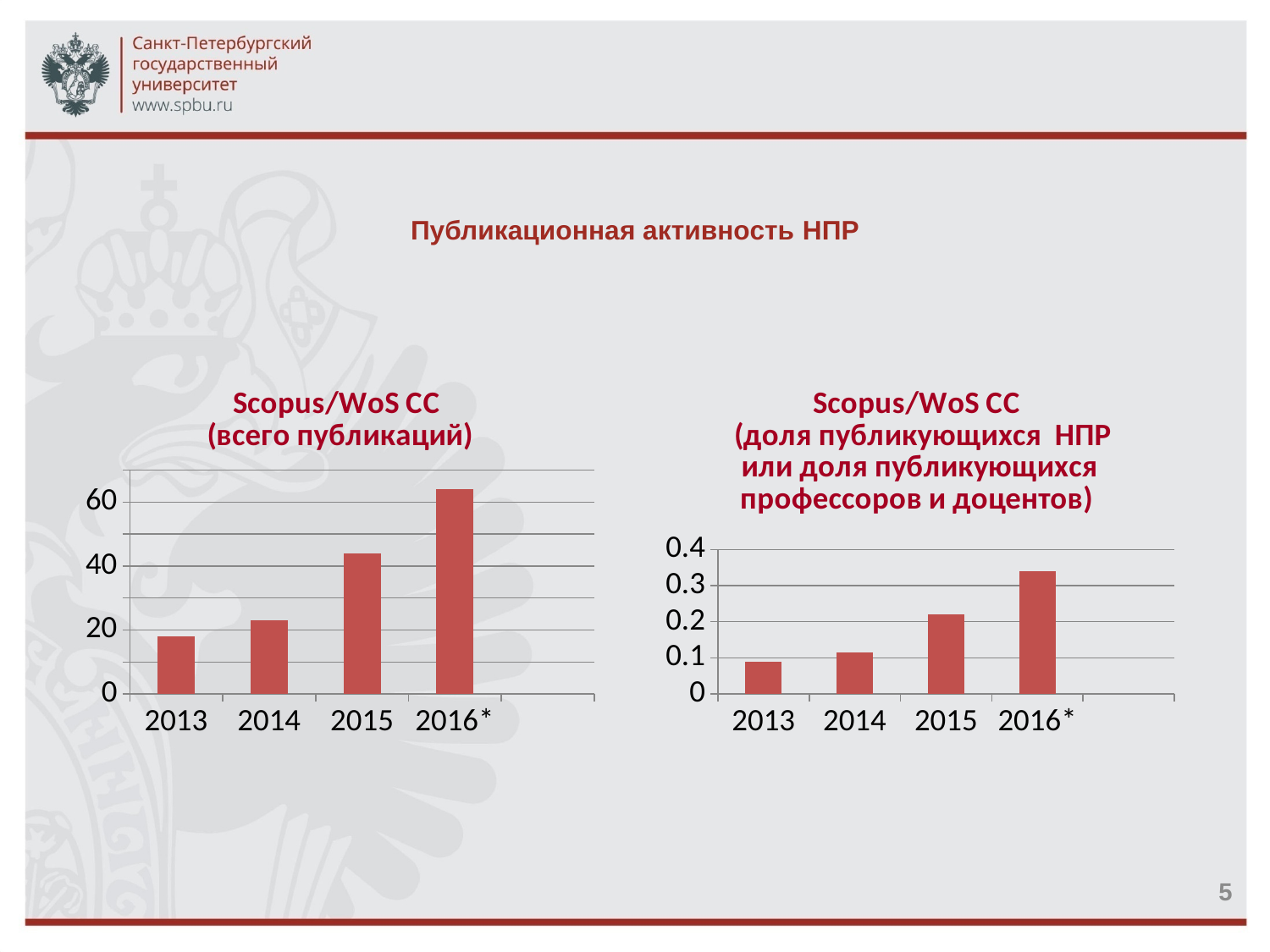
In the right chart, 'Scopus/WoS CC (доля публикующихся НПР...)', is the value for 2016* greater or less than 0.3? greater How many years are shown on the x axis of the left chart, 'Scopus/WoS CC (всего публикаций)'? 4 In the left chart, 'Scopus/WoS CC (всего публикаций)', which year has the lowest value? 2013 In the left chart, 'Scopus/WoS CC (всего публикаций)', is the value for 2013 greater or less than 20? less In the right chart, 'Scopus/WoS CC (доля публикующихся НПР...)', which is larger, the value for 2015 or the value for 2014? 2015 What is the title of the slide above the two charts? Публикационная активность НПР In the left chart, 'Scopus/WoS CC (всего публикаций)', is the value for 2016* greater or less than 60? greater In the left chart, 'Scopus/WoS CC (всего публикаций)', do the values rise or fall from 2013 to 2016*? rise In the left chart, 'Scopus/WoS CC (всего публикаций)', which year has the highest value? 2016* What kind of chart is the left chart, 'Scopus/WoS CC (всего публикаций)'? bar chart In the right chart, 'Scopus/WoS CC (доля публикующихся НПР...)', which year has the highest value? 2016*